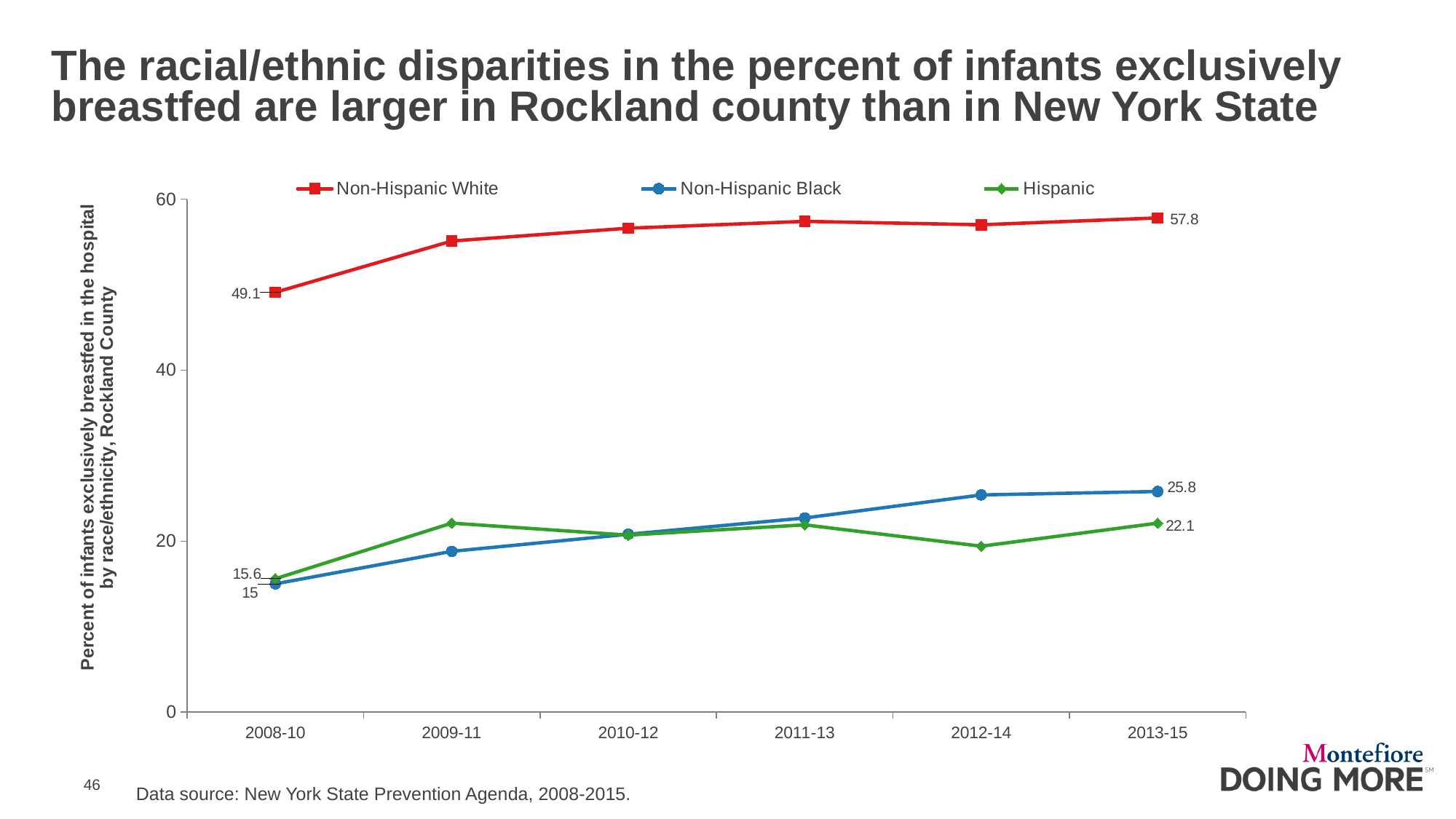
Is the value for Non-Hispanic White in 2011-13 greater or less than 40? greater Which series has the highest value in 2013-15? Non-Hispanic White What is the value for Non-Hispanic Black in 2008-10? 15 How many series does the legend list? 3 How many time periods are shown on the x axis? 6 What type of chart is shown on the slide? line chart What is the value for Non-Hispanic White in 2008-10? 49.1 What is the value for Non-Hispanic Black in 2013-15? 25.8 What is the difference between the Non-Hispanic White values in 2013-15 and 2008-10? 8.7 What is the value for Hispanic in 2008-10? 15.6 Does the Non-Hispanic Black series rise or fall from 2008-10 to 2013-15? rise What is the value for Non-Hispanic White in 2013-15? 57.8